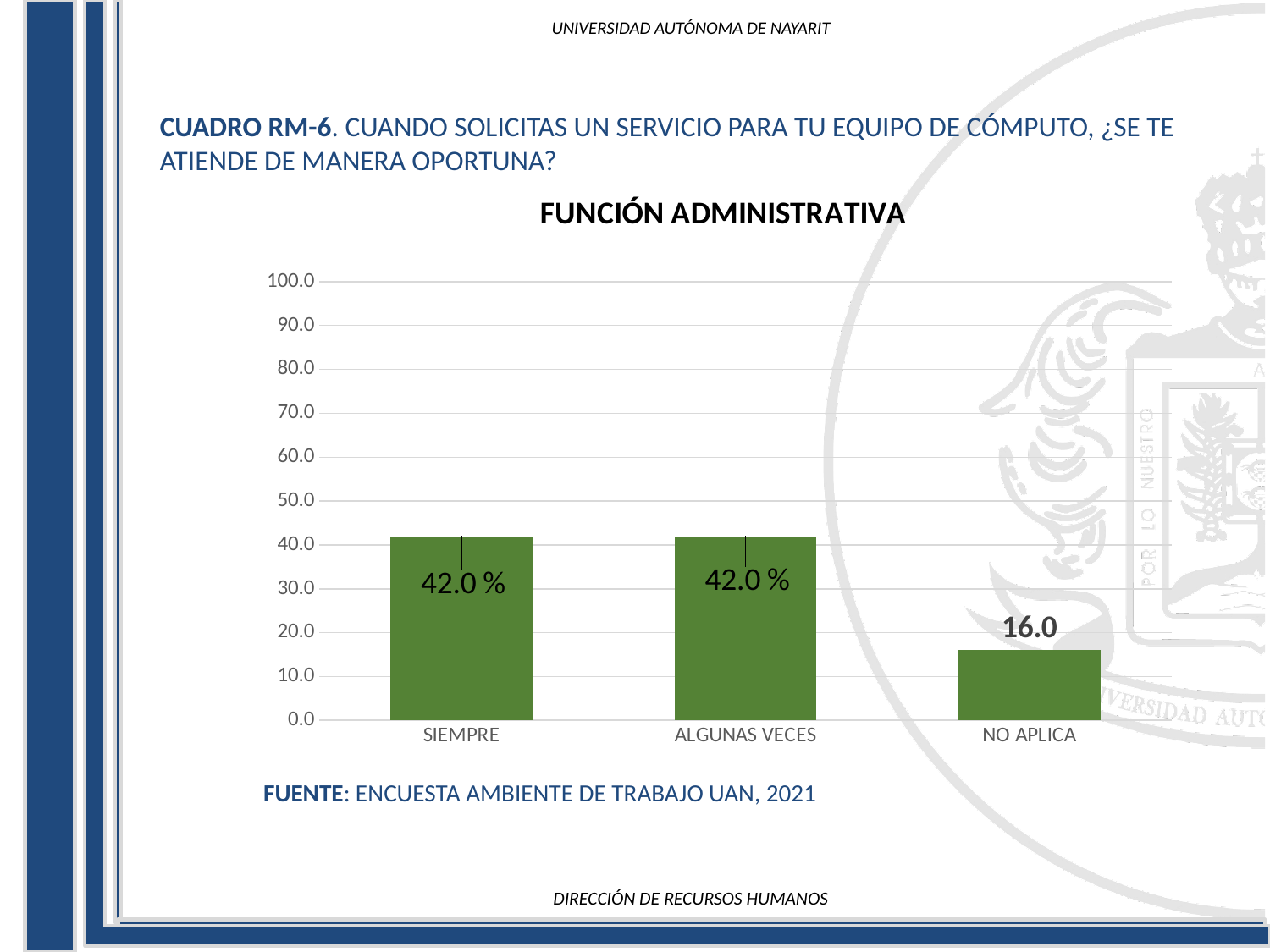
Is the value for SIEMPRE greater or less than 50.0? less Which category has the lowest value? NO APLICA What kind of chart is shown on the slide? bar chart What is the value for ALGUNAS VECES? 42.0 % Which is larger, the value for ALGUNAS VECES or the value for NO APLICA? ALGUNAS VECES What is the value for NO APLICA? 16.0 What is the highest value shown on the y axis? 100.0 Is the value for NO APLICA greater or less than 20.0? less What is the title of the chart? FUNCIÓN ADMINISTRATIVA What is the difference between the values for SIEMPRE and NO APLICA? 26.0 What is the value for SIEMPRE? 42.0 % How many categories are shown on the x axis? 3